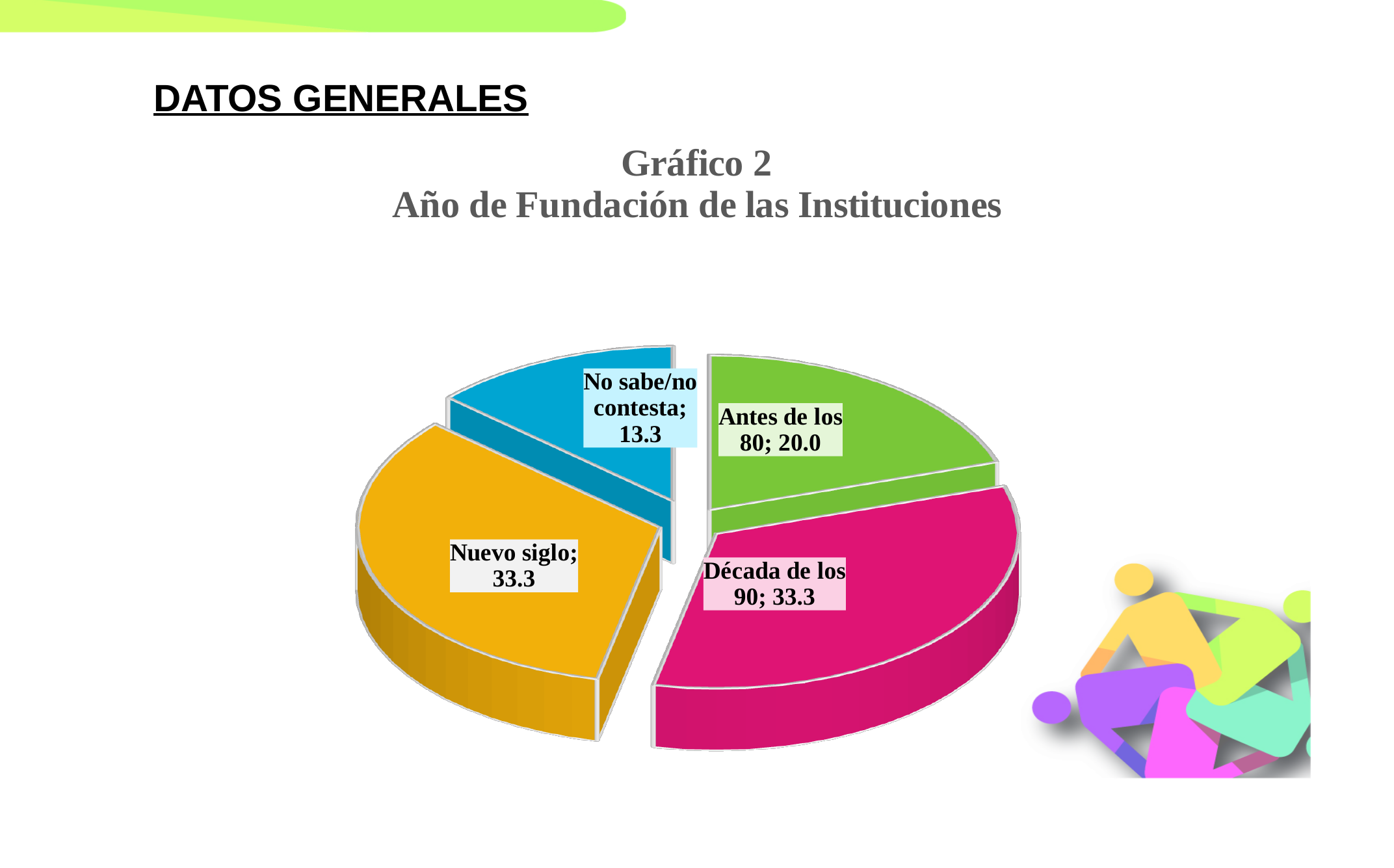
Which category has the smallest slice of the pie? No sabe/no contesta What type of chart is shown on the slide? Pie chart What is the value for "Década de los 90"? 33.3 Which is larger, the value for "Antes de los 80" or the value for "No sabe/no contesta"? Antes de los 80 What is the title of the chart? Gráfico 2 Año de Fundación de las Instituciones What colour is the "Década de los 90" slice? Magenta (pink) What is the value for "No sabe/no contesta"? 13.3 What is the difference between the values for "Antes de los 80" and "No sabe/no contesta"? 6.7 What is the value for "Antes de los 80"? 20.0 What is the difference between the values for "Nuevo siglo" and "Antes de los 80"? 13.3 What is the value for "Nuevo siglo"? 33.3 How many categories are shown in the pie chart? 4